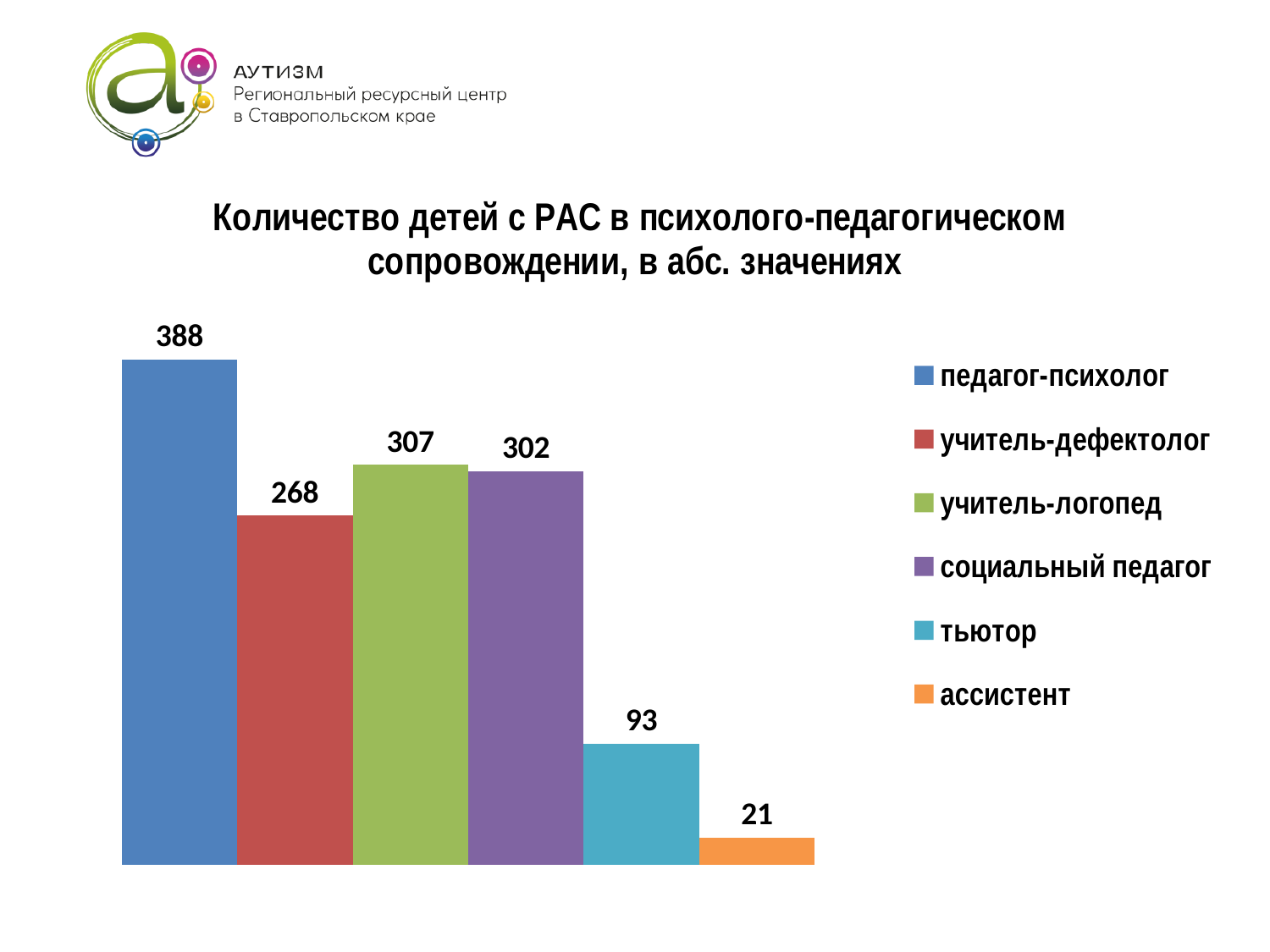
Which category has the lowest value? ассистент What is the difference between the values for педагог-психолог and учитель-дефектолог? 120 What colour is the bar for социальный педагог? purple What kind of chart is shown on the slide? bar chart What is the difference between the values for тьютор and ассистент? 72 Which category has the highest value? педагог-психолог Which is larger, the value for учитель-логопед or the value for учитель-дефектолог? учитель-логопед What is the value for педагог-психолог? 388 What is the value for учитель-дефектолог? 268 What is the value for ассистент? 21 What is the value for тьютор? 93 How many categories does the legend list? 6